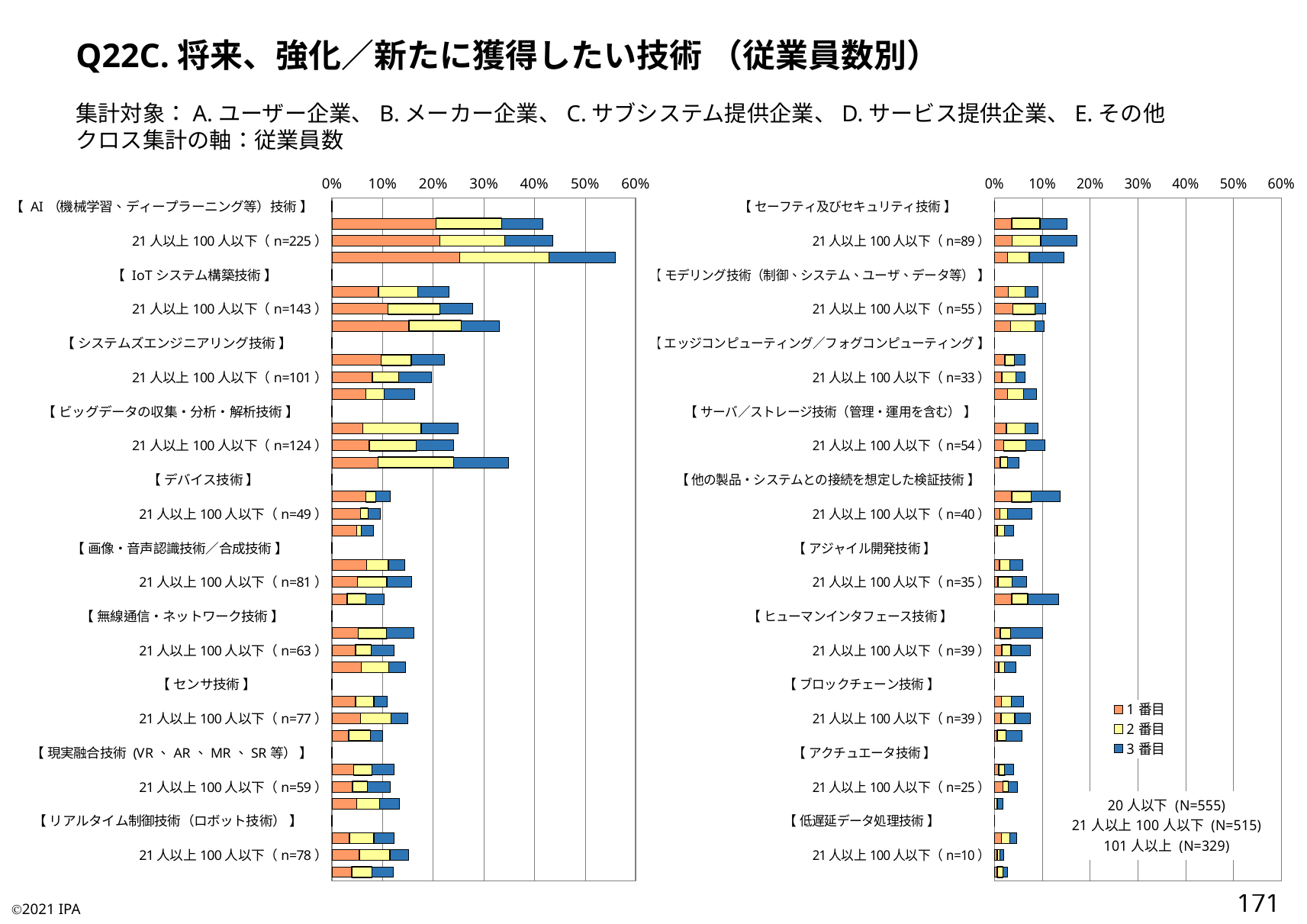
In the left chart, is the total bar for 101人以上 under IoTシステム構築技術 greater or less than 30%? greater What kind of chart is used on this slide? Stacked bar chart What are the three legend entries? 1番目, 2番目, 3番目 How many series does the legend list? 3 In the left chart, which technology category has the longest bar? AI（機械学習、ディープラーニング等）技術 What is the maximum value shown on the horizontal axis of each chart? 60% In the left chart, how many technology categories (bracketed headings) are shown? 10 In the right chart, is the total bar for 21人以上100人以下 (n=89) under セーフティ及びセキュリティ技術 greater or less than 20%? less In the left chart, is the total bar for 101人以上 under AI（機械学習、ディープラーニング等）技術 greater or less than 50%? greater In the right chart, how many technology categories (bracketed headings) are shown? 10 In the left chart, which is larger for 101人以上: the total bar for AI（機械学習、ディープラーニング等）技術 or for IoTシステム構築技術? AI（機械学習、ディープラーニング等）技術